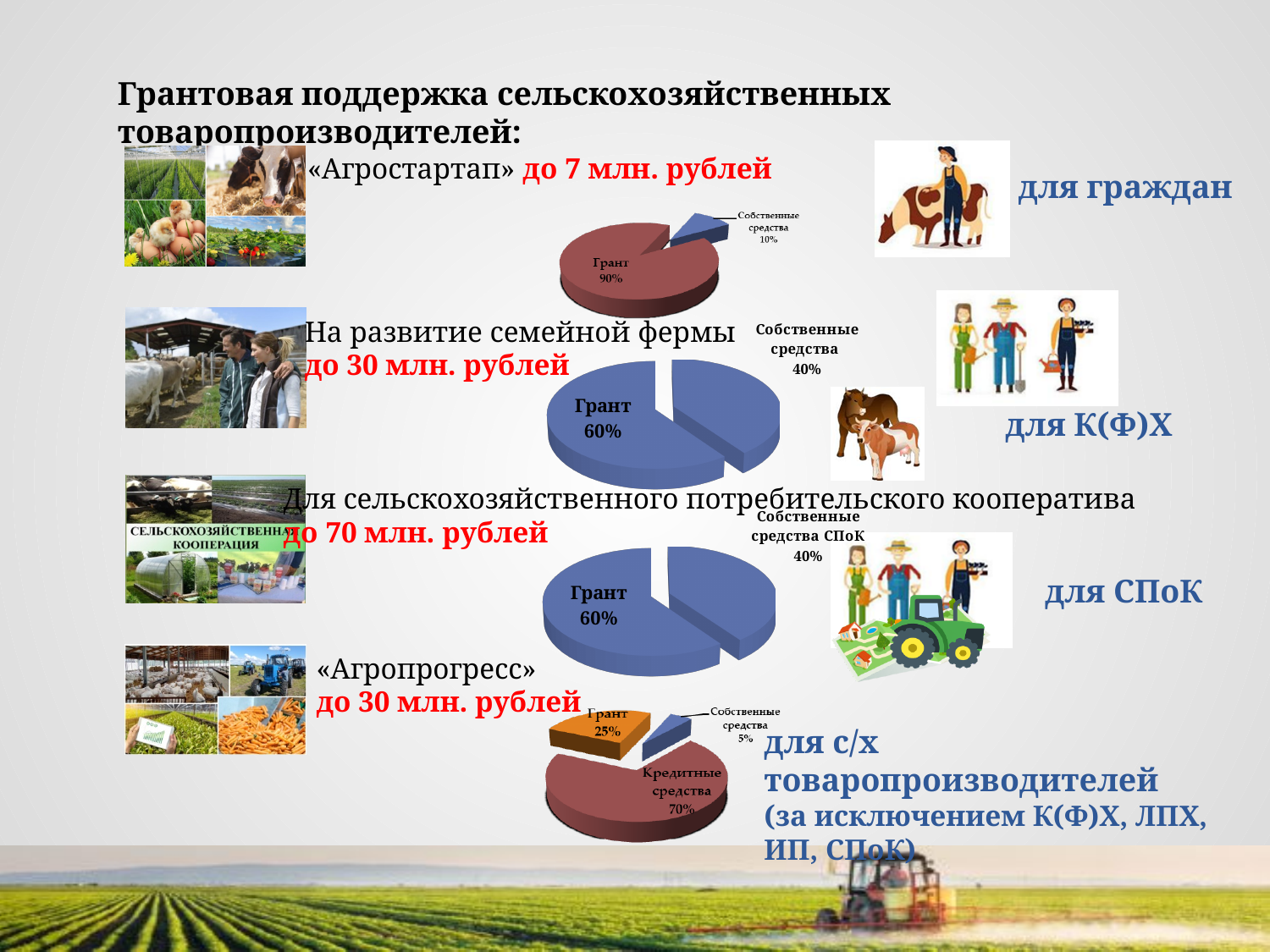
In the top pie chart next to «Агростартап», what share is labelled Собственные средства? 10% In the bottom pie chart next to «Агропрогресс», which slice is the smallest? Собственные средства In the bottom pie chart next to «Агропрогресс», what share is labelled Грант? 25% In the second pie chart from the top (next to «На развитие семейной фермы»), what share is labelled Собственные средства? 40% In the second pie chart from the top (next to «На развитие семейной фермы»), what share is labelled Грант? 60% In the top pie chart next to «Агростартап», which slice is the largest? Грант In the third pie chart from the top (for СПоК), what share is labelled Собственные средства СПоК? 40% In the top pie chart next to «Агростартап», what share is labelled Грант? 90% In the third pie chart from the top (for СПоК), how many slices does the pie have? 2 In the bottom pie chart next to «Агропрогресс», what share is labelled Кредитные средства? 70% In the second pie chart from the top, what is the difference between the Грант share and the Собственные средства share? 20% How many pie charts are shown on the slide? 4